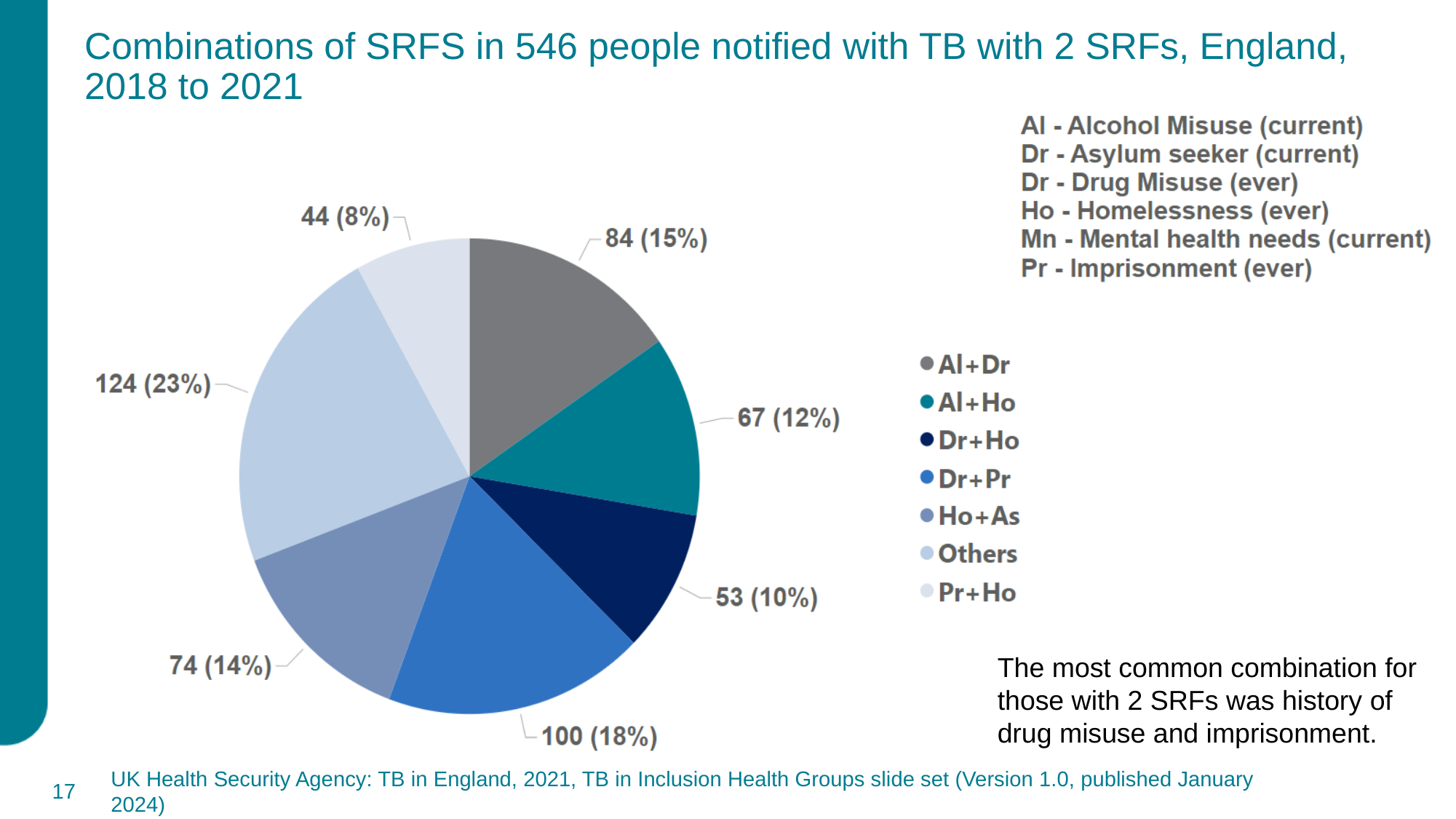
How many slices does the pie chart have? 7 What is the value shown for the Al+Dr slice? 84 (15%) What is the value shown for the Ho+As slice? 74 (14%) Which slice of the pie chart is the smallest? Pr+Ho According to the key on the slide, what does the abbreviation Ho stand for? Homelessness (ever) What is the value shown for the Al+Ho slice? 67 (12%) What share of the pie does the Dr+Ho slice represent? 10% Which is larger, the Al+Ho slice or the Ho+As slice? Ho+As What is the difference in count between the Others slice and the Dr+Pr slice? 24 Which slice of the pie chart is the largest? Others What is the value shown for the Dr+Pr slice? 100 (18%) What kind of chart is shown on the slide? pie chart